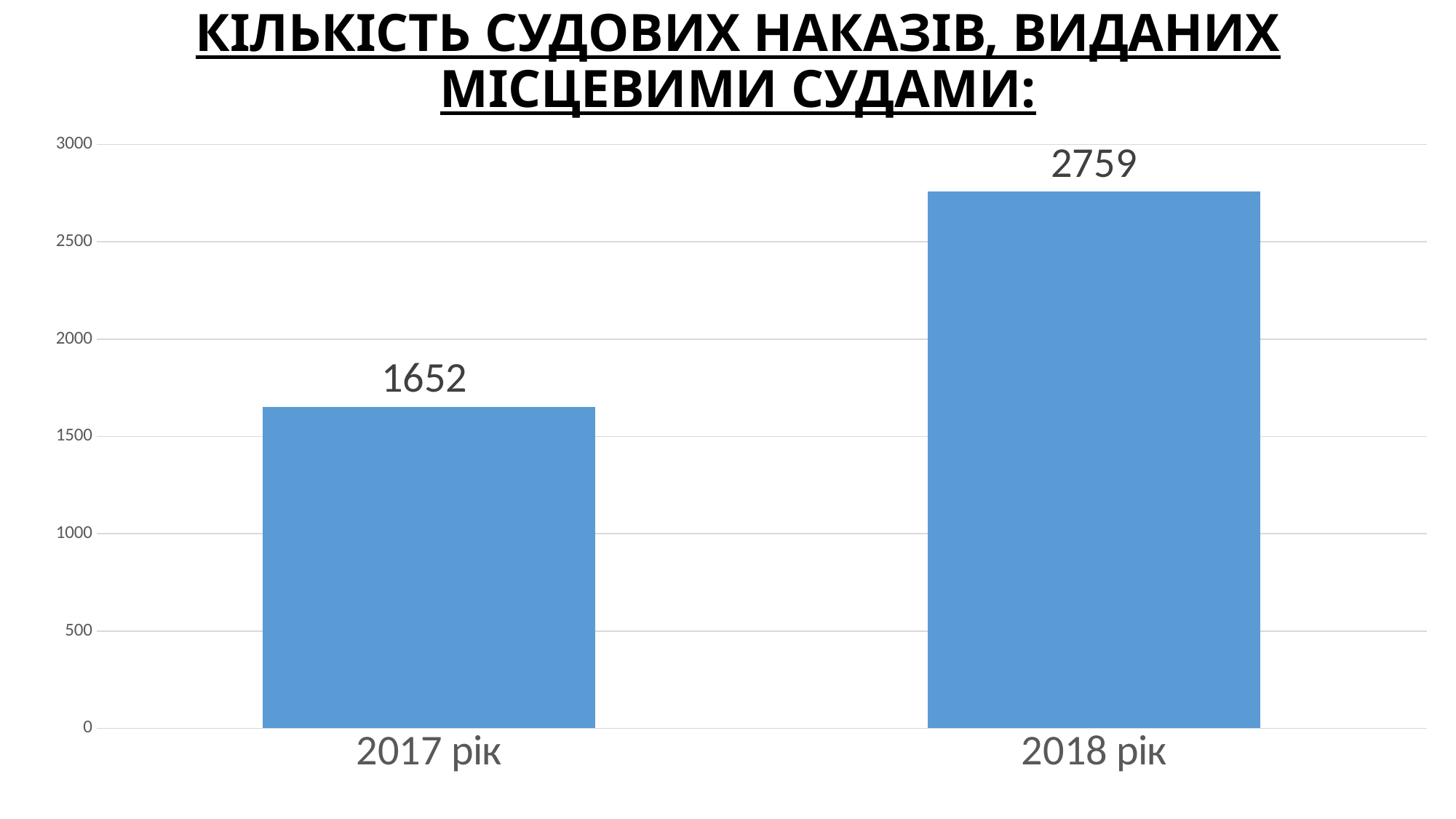
What is the difference between the values for 2018 рік and 2017 рік? 1107 Do the values rise or fall from 2017 рік to 2018 рік? rise Which year has the highest value? 2018 рік What kind of chart is shown on the slide? bar chart What is the value for 2018 рік? 2759 Is the value for 2018 рік greater or less than 2500? greater Is the value for 2017 рік greater or less than 2000? less What is the value for 2017 рік? 1652 Which is larger, the value for 2017 рік or the value for 2018 рік? 2018 рік What is the title of the chart? КІЛЬКІСТЬ СУДОВИХ НАКАЗІВ, ВИДАНИХ МІСЦЕВИМИ СУДАМИ: Which year has the lowest value? 2017 рік How many categories are shown on the chart? 2